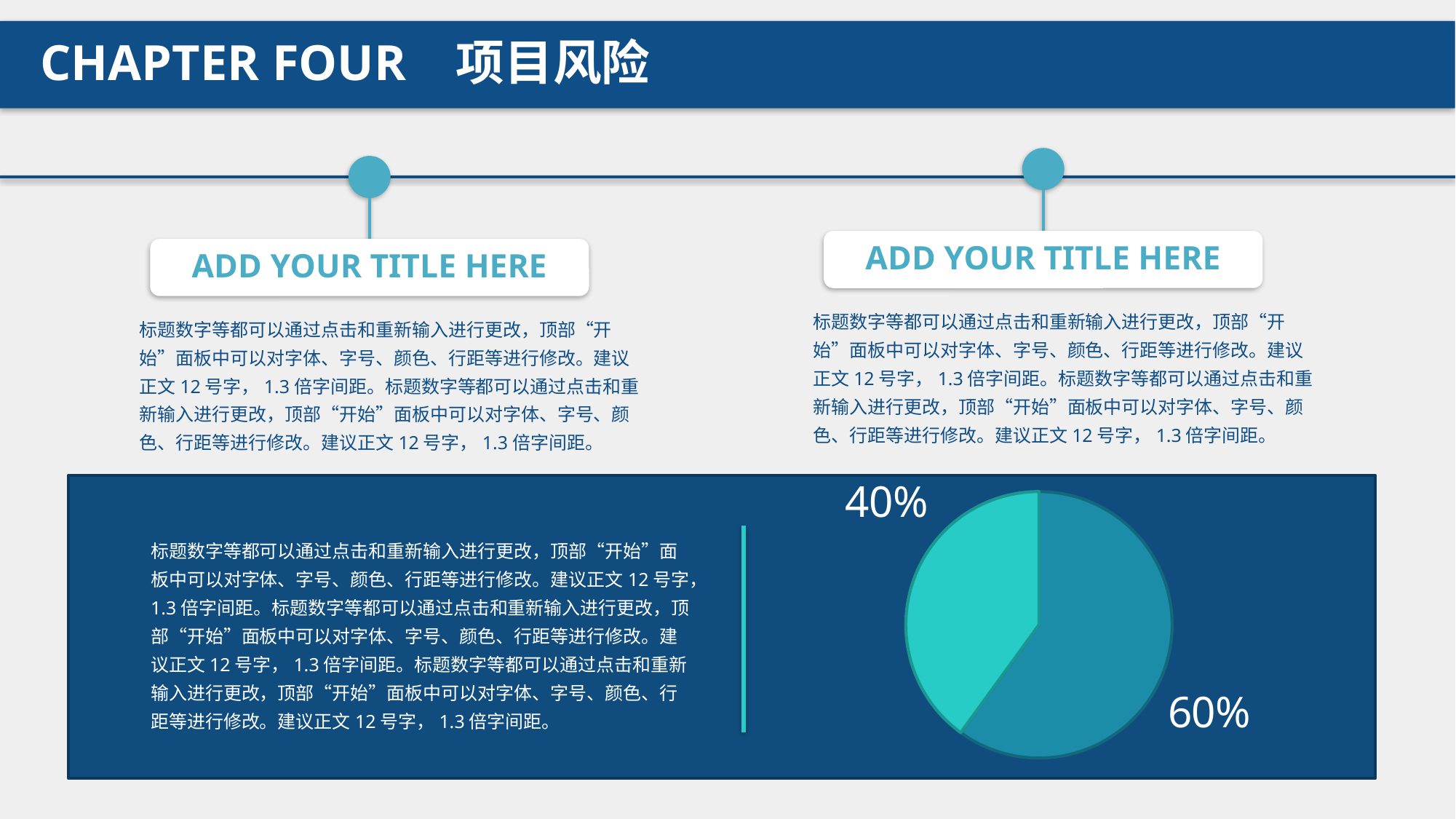
What is the difference between the two slices of the pie chart? 20% What share of the pie does the darker blue-teal slice represent? 60% What kind of chart is shown on the slide? pie chart Which slice is larger, the one labelled 40% or the one labelled 60%? 60% Does the pie chart have a legend? No What share of the pie does the bright teal slice represent? 40% What colour is the slice labelled 40%? bright teal Is the bright teal slice greater or less than 50% of the pie? less How many slices does the pie chart have? 2 What do the two slices of the pie chart add up to? 100% What is the value of the largest slice in the pie chart? 60% What is the value of the smallest slice in the pie chart? 40%